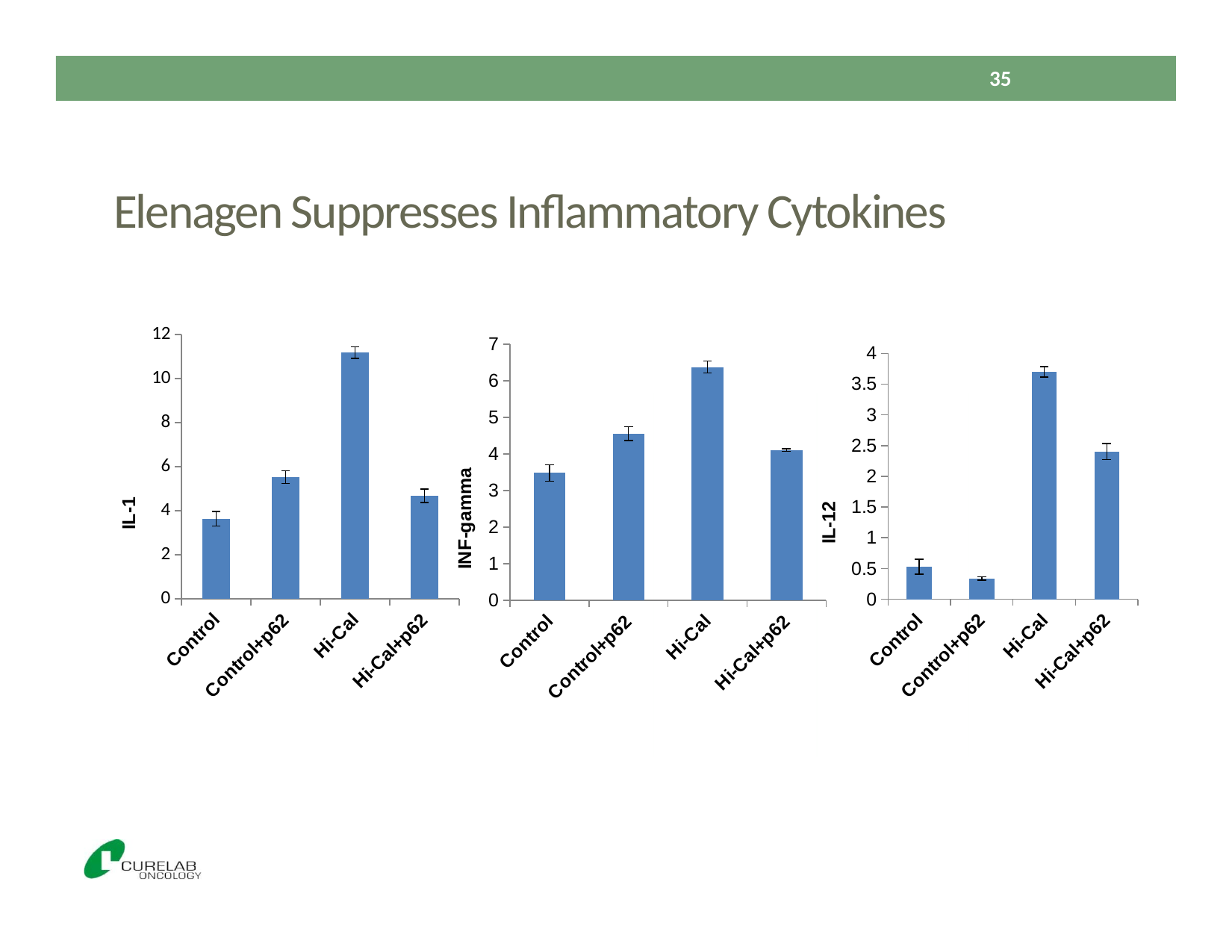
How many categories are shown on the x axis of the right chart (IL-12)? 4 In the middle chart (INF-gamma), which category has the highest bar? Hi-Cal In the middle chart (INF-gamma), which is larger, Control+p62 or Hi-Cal+p62? Control+p62 In the left chart (IL-1), is the value for Control+p62 greater or less than 6? less In the left chart (IL-1), which category has the lowest bar? Control In the left chart (IL-1), is the value for Hi-Cal greater or less than 10? greater In the right chart (IL-12), is the value for Hi-Cal greater or less than 3.5? greater In the left chart (IL-1), which category has the highest bar? Hi-Cal In the right chart (IL-12), which category has the lowest bar? Control+p62 In the middle chart (INF-gamma), which category has the lowest bar? Control What kind of chart is the left chart (IL-1)? bar chart